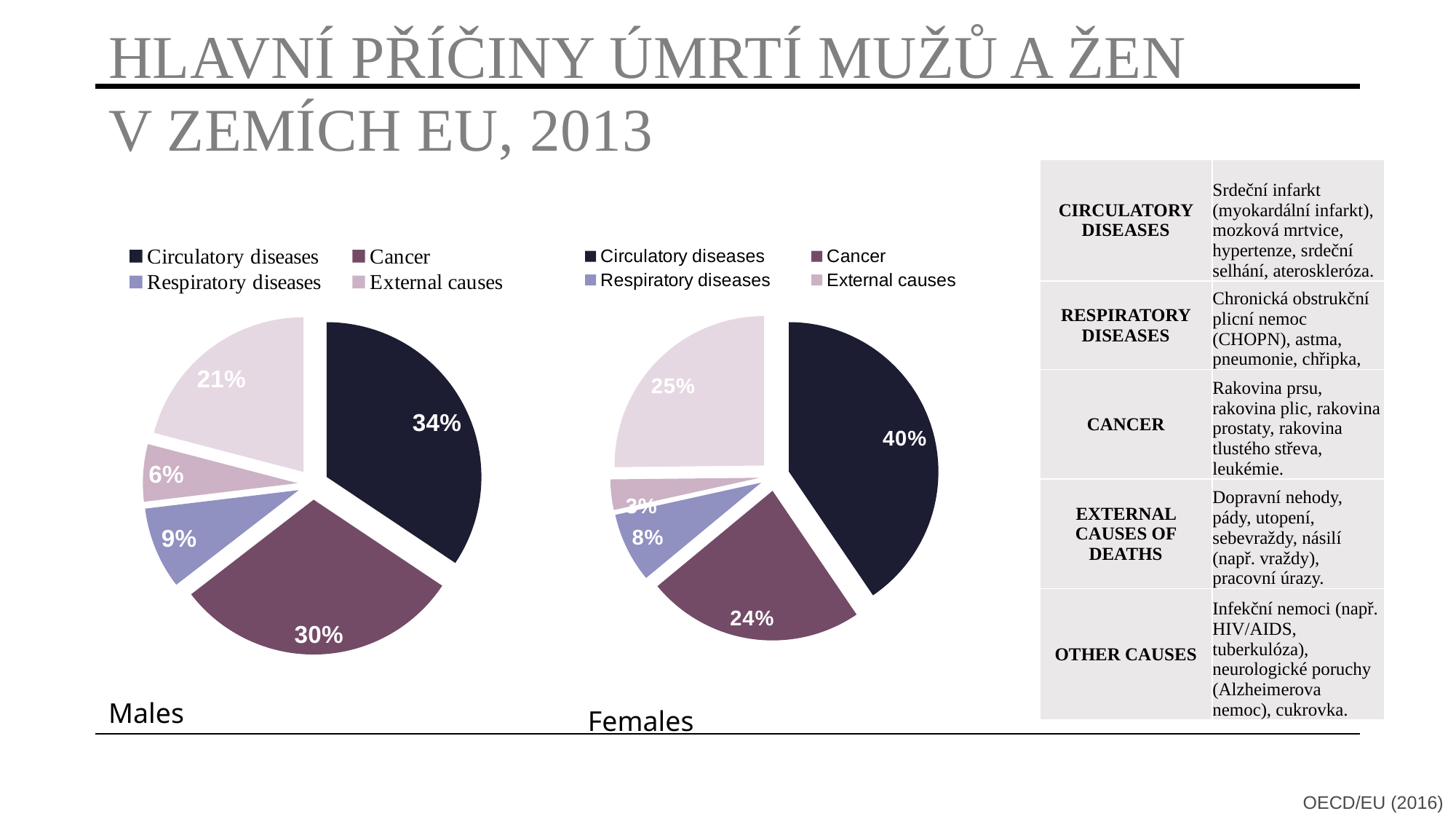
In the Males pie chart, which cause of death has the largest slice? Circulatory diseases In the Males pie chart, what is the difference between the cancer share and the external causes share? 24% In the Males pie chart, what share of deaths is attributed to circulatory diseases? 34% In the Females pie chart, what percentage is shown for external causes? 3% How many slices does the Females pie chart have? 5 Is the cancer share larger for males or for females? Males What type of chart is used to show the causes of death for males? Pie chart What is the difference between the circulatory diseases share for females and for males? 6% In the Males pie chart, what percentage is shown for respiratory diseases? 9% In the Females pie chart, what share of deaths is attributed to cancer? 24% In the Females pie chart, which cause of death has the largest slice? Circulatory diseases How many entries does the legend of the Males chart list? 4